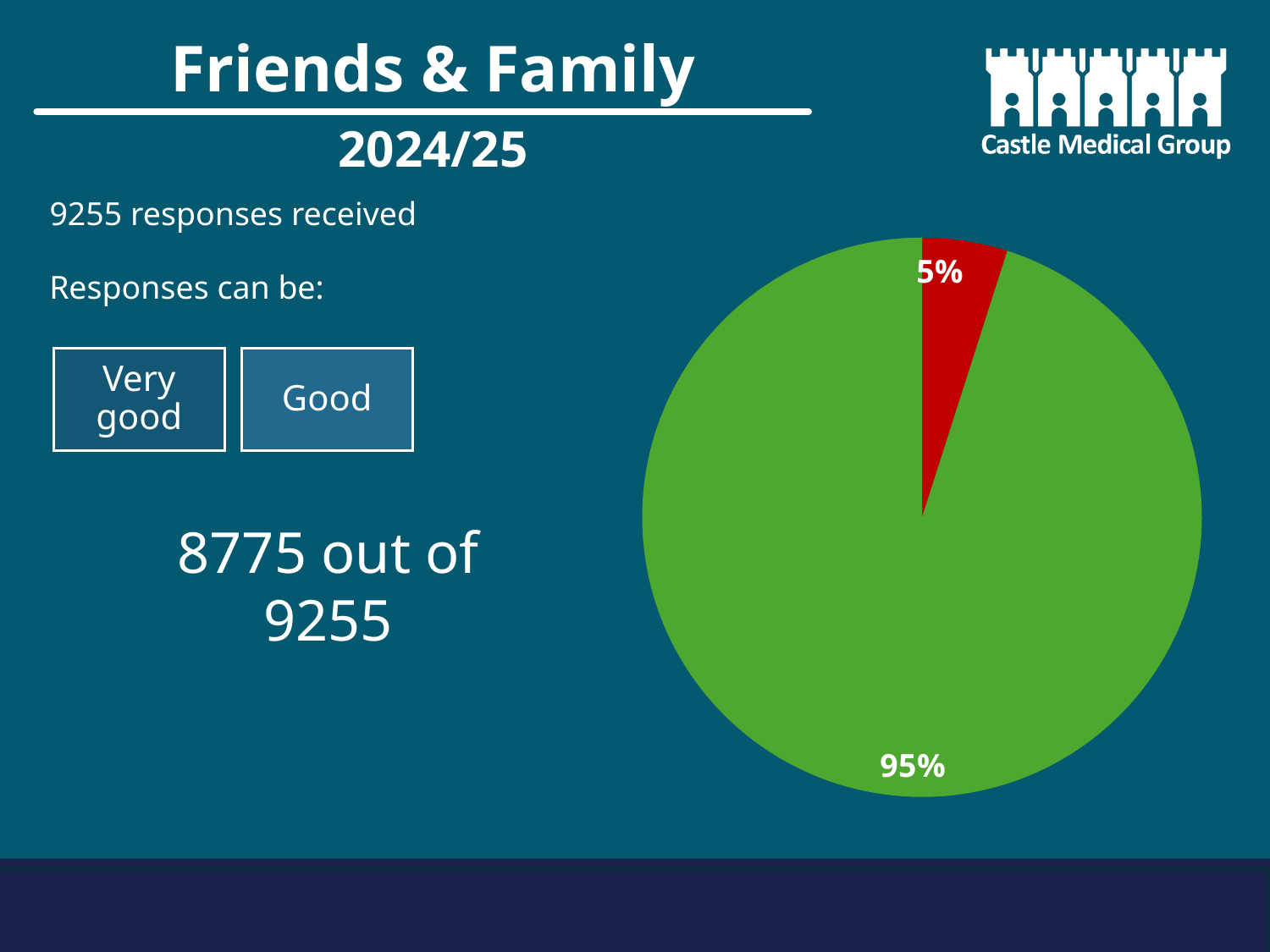
Which is larger, the green slice or the red slice? the green slice What share of the pie does the green slice represent? 95% Is the share of the green slice greater or less than 50%? greater Which slice of the pie chart is the smallest? the red slice (5%) What kind of chart is shown on the slide? pie chart What two colours are used for the slices of the pie chart? green and red How many slices does the pie chart have? 2 What value is printed on the red slice of the pie chart? 5% What share of the pie does the red slice represent? 5% What value is printed on the green slice of the pie chart? 95% What is the difference in percentage points between the green slice and the red slice? 90 percentage points Which slice of the pie chart is the largest? the green slice (95%)